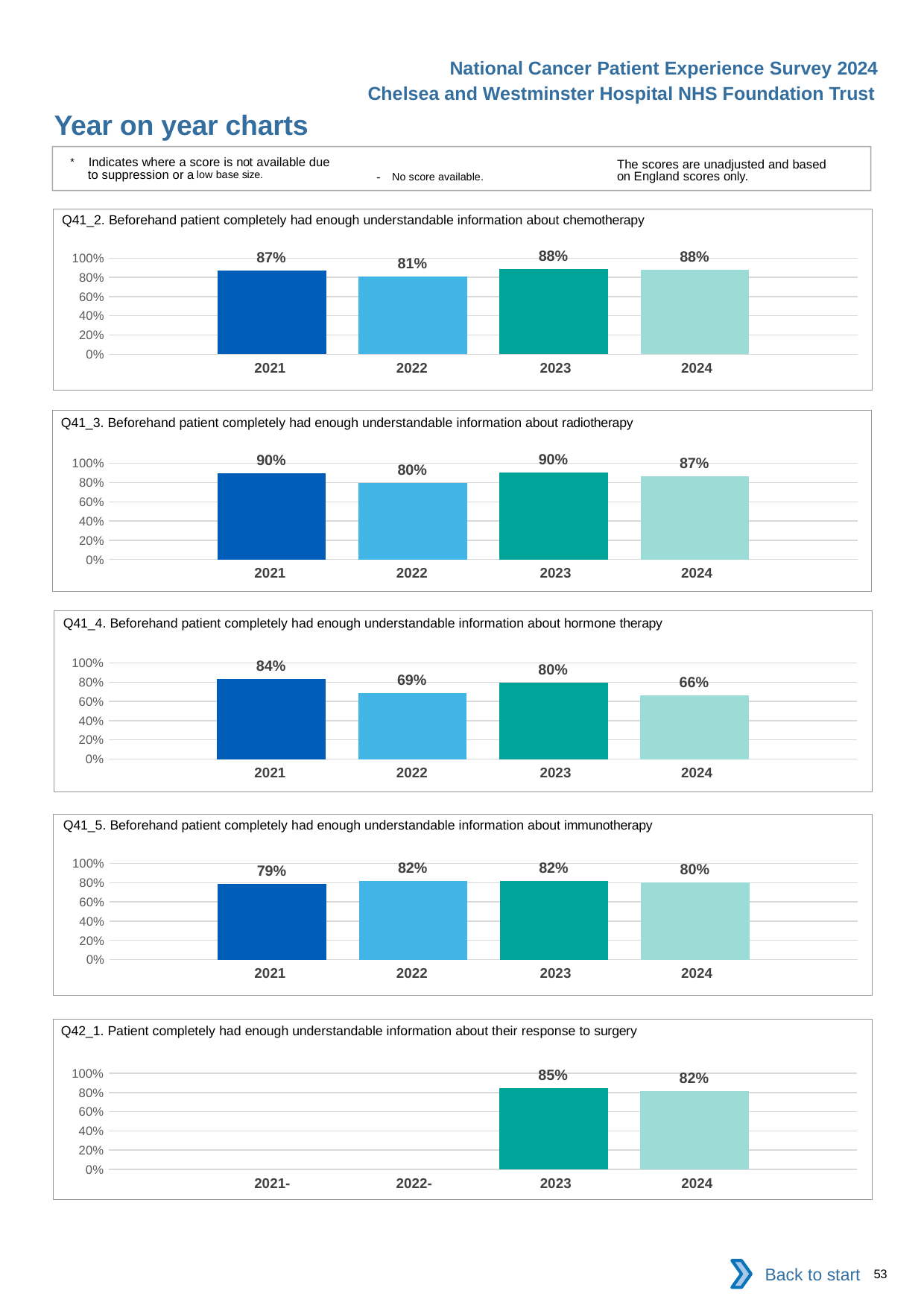
In the Q42_1 chart (response to surgery), which is larger, the 2023 value or the 2024 value? 2023 How many charts are shown on the slide? 5 In the Q41_3 chart (radiotherapy), what is the difference between the 2023 and 2024 values? 3% In the Q41_4 chart (hormone therapy), is the value for 2022 greater or less than 80%? less In the Q41_3 chart (radiotherapy), which year has the lowest value? 2022 In the Q42_1 chart (response to surgery), how many years have a bar plotted? 2 In the Q41_5 chart (immunotherapy), what is the value for 2021? 79% In the Q41_4 chart (hormone therapy), which year has the highest value? 2021 In the Q41_4 chart (hormone therapy), what is the difference between the 2021 and 2024 values? 18% What kind of chart is the Q41_3 chart (radiotherapy)? Bar chart In the Q41_2 chart (chemotherapy), what is the value for 2024? 88% In the Q41_2 chart (chemotherapy), what is the value for 2022? 81%